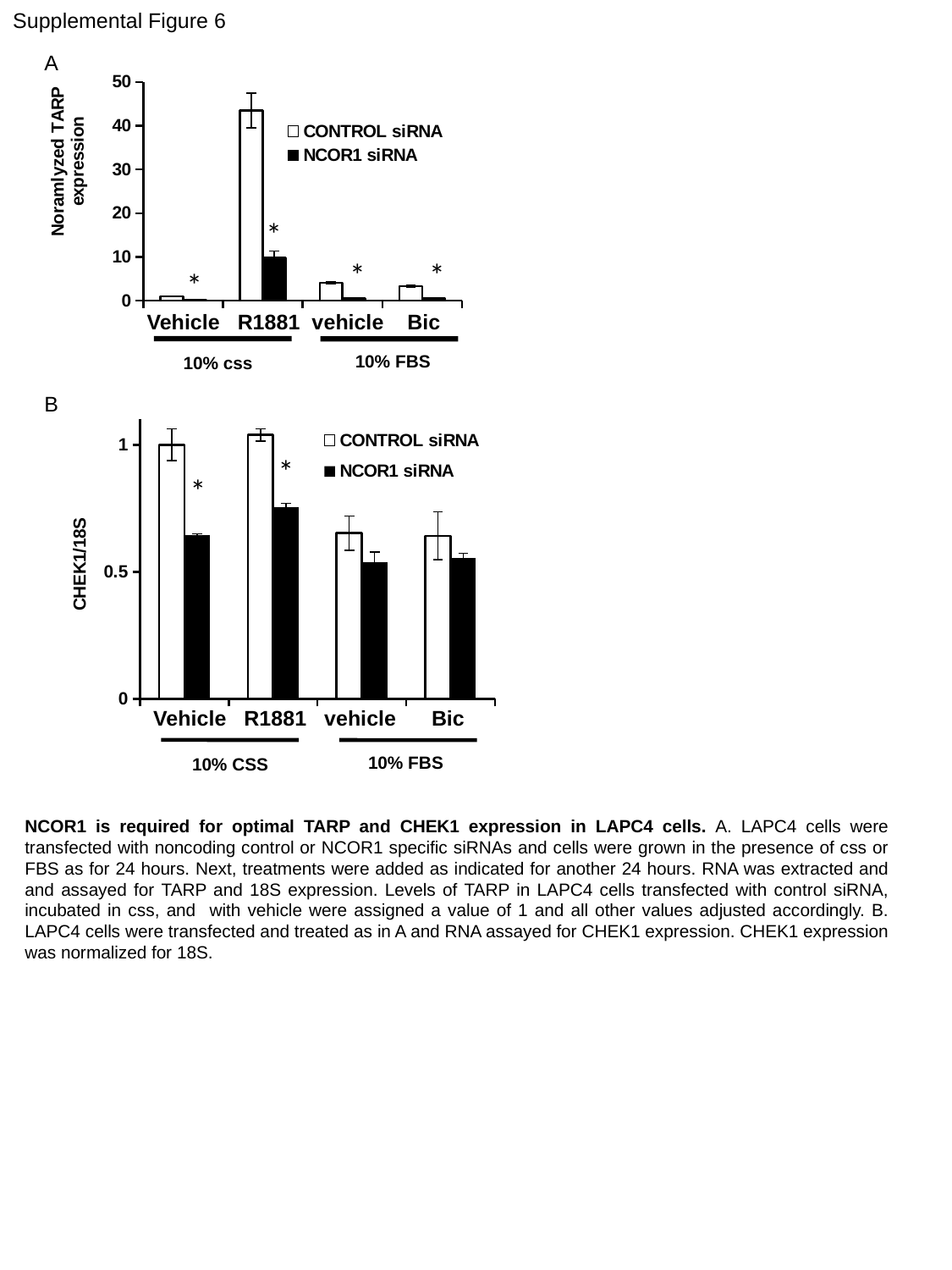
In chart B (bottom), is the NCOR1 siRNA value for Vehicle under 10% CSS greater or less than 0.5? greater In chart A (top), for R1881, which series has the larger value, CONTROL siRNA or NCOR1 siRNA? CONTROL siRNA In chart B (bottom), what is the label on the y axis? CHEK1/18S In chart A (top), which category has the highest CONTROL siRNA bar? R1881 In chart B (bottom), for Vehicle under 10% CSS, which series has the larger value, CONTROL siRNA or NCOR1 siRNA? CONTROL siRNA In chart A (top), what kind of chart is shown? bar chart In chart B (bottom), how many categories are shown on the x axis? 4 In chart A (top), how many treatment categories are shown on the x axis? 4 In chart A (top), is the NCOR1 siRNA value for R1881 greater or less than 20? less In chart A (top), is the CONTROL siRNA value for R1881 greater or less than 30? greater In chart B (bottom), what kind of chart is shown? bar chart In chart A (top), how many series does the legend list? 2